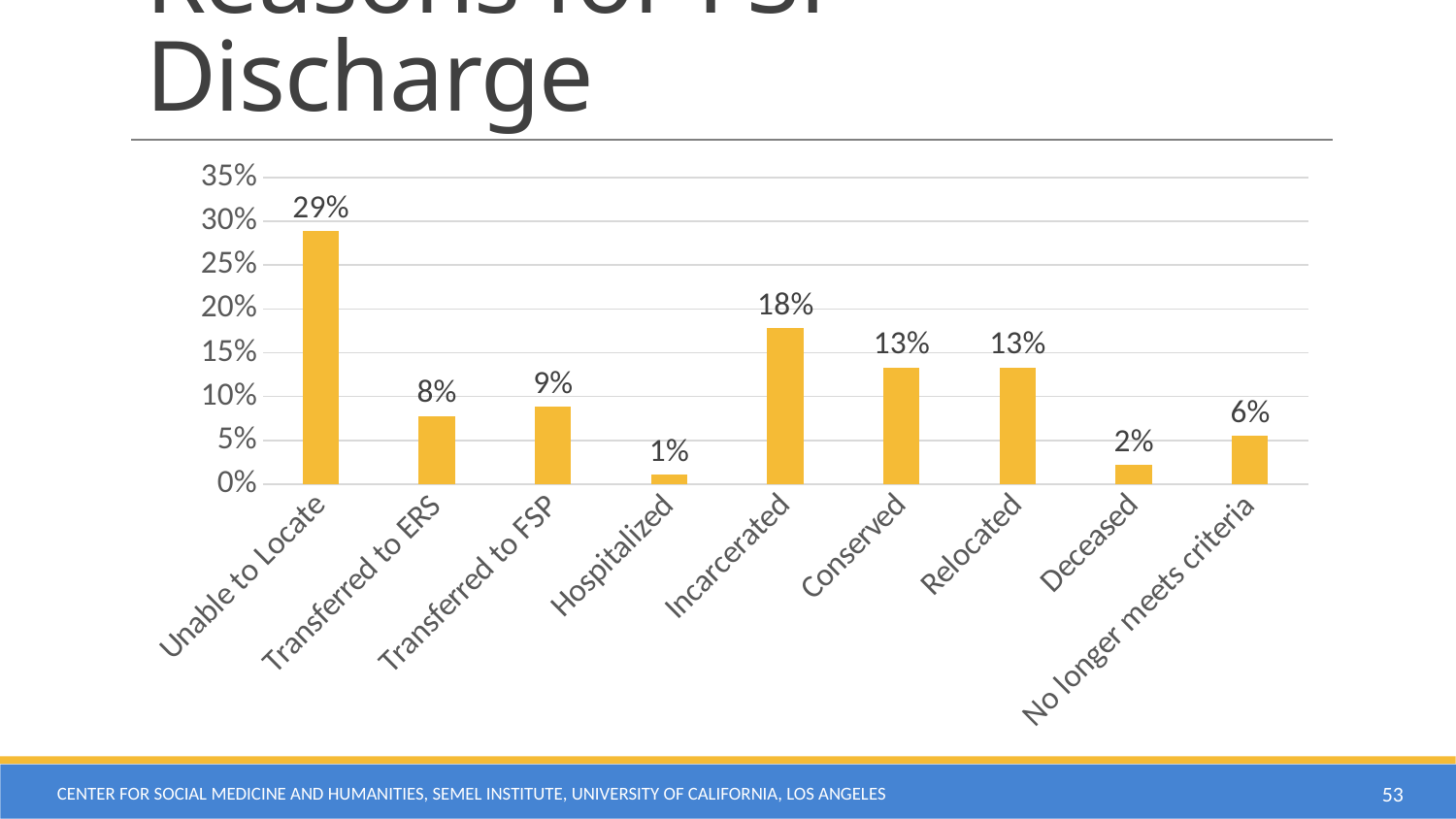
Is the value for Conserved greater or less than 10%? greater What is the difference between the percentages for Unable to Locate and Incarcerated? 11% Which reason for discharge has the lowest percentage? Hospitalized How many reasons for discharge are shown on the x axis? 9 Which reason for discharge has the highest percentage? Unable to Locate What kind of chart is shown on the slide? Bar chart What percentage is shown for Unable to Locate? 29% Which is larger, the value for Transferred to FSP or the value for Transferred to ERS? Transferred to FSP What percentage is shown for No longer meets criteria? 6% What is the difference between the percentages for Deceased and No longer meets criteria? 4% What percentage is shown for Incarcerated? 18% What percentage is shown for Hospitalized? 1%